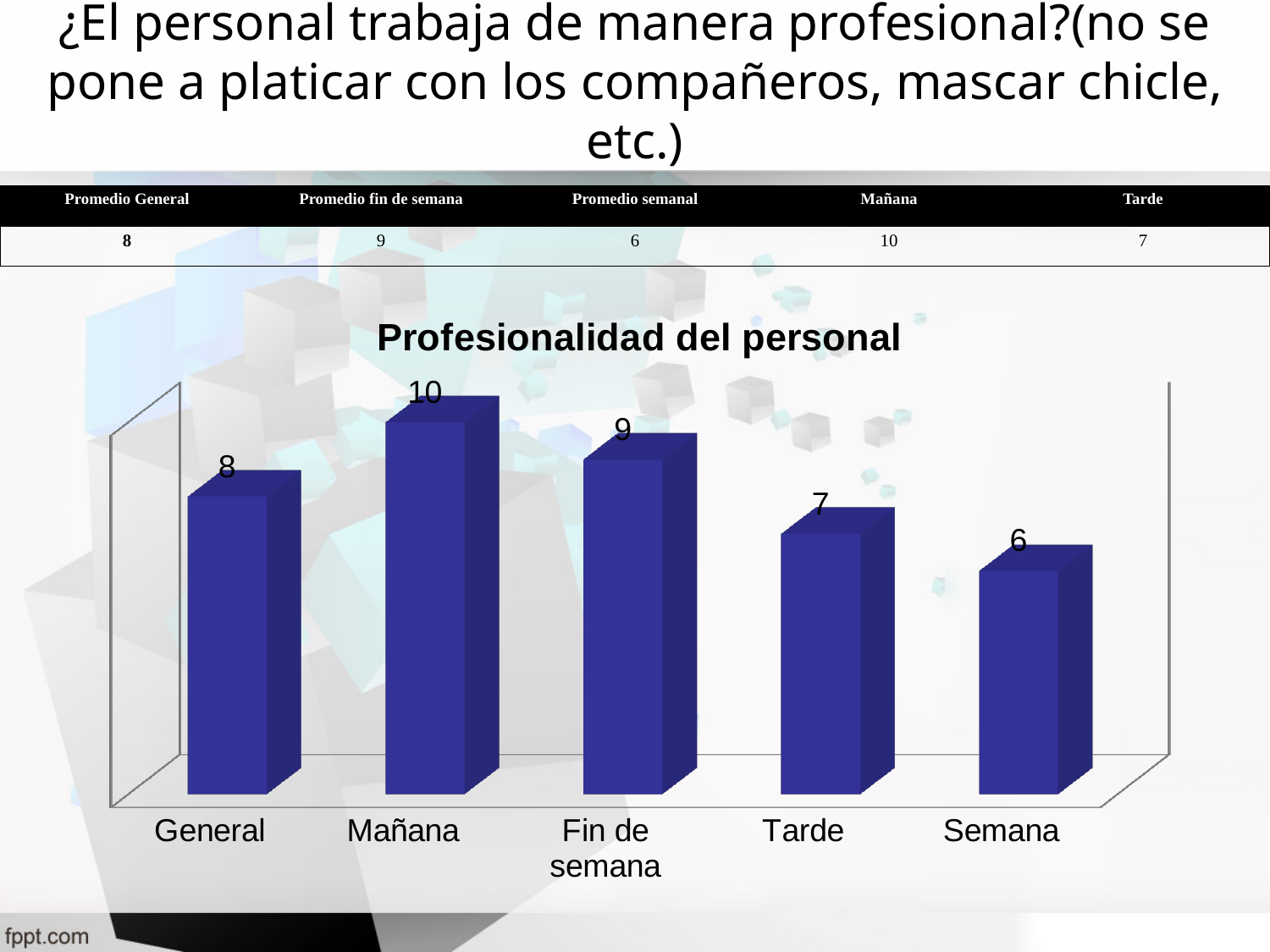
Which category has the highest value in the chart? Mañana What is the value for Mañana in the chart? 10 What is the title of the chart? Profesionalidad del personal What is the difference between the values for Tarde and Semana? 1 What is the difference between the values for Mañana and Tarde? 3 What is the value for General in the chart? 8 How many categories are shown in the chart? 5 Which category has the lowest value in the chart? Semana What is the value for Fin de semana in the chart? 9 Which is larger, the value for General or the value for Fin de semana? Fin de semana What is the value for Semana in the chart? 6 What kind of chart is shown on the slide? Bar chart